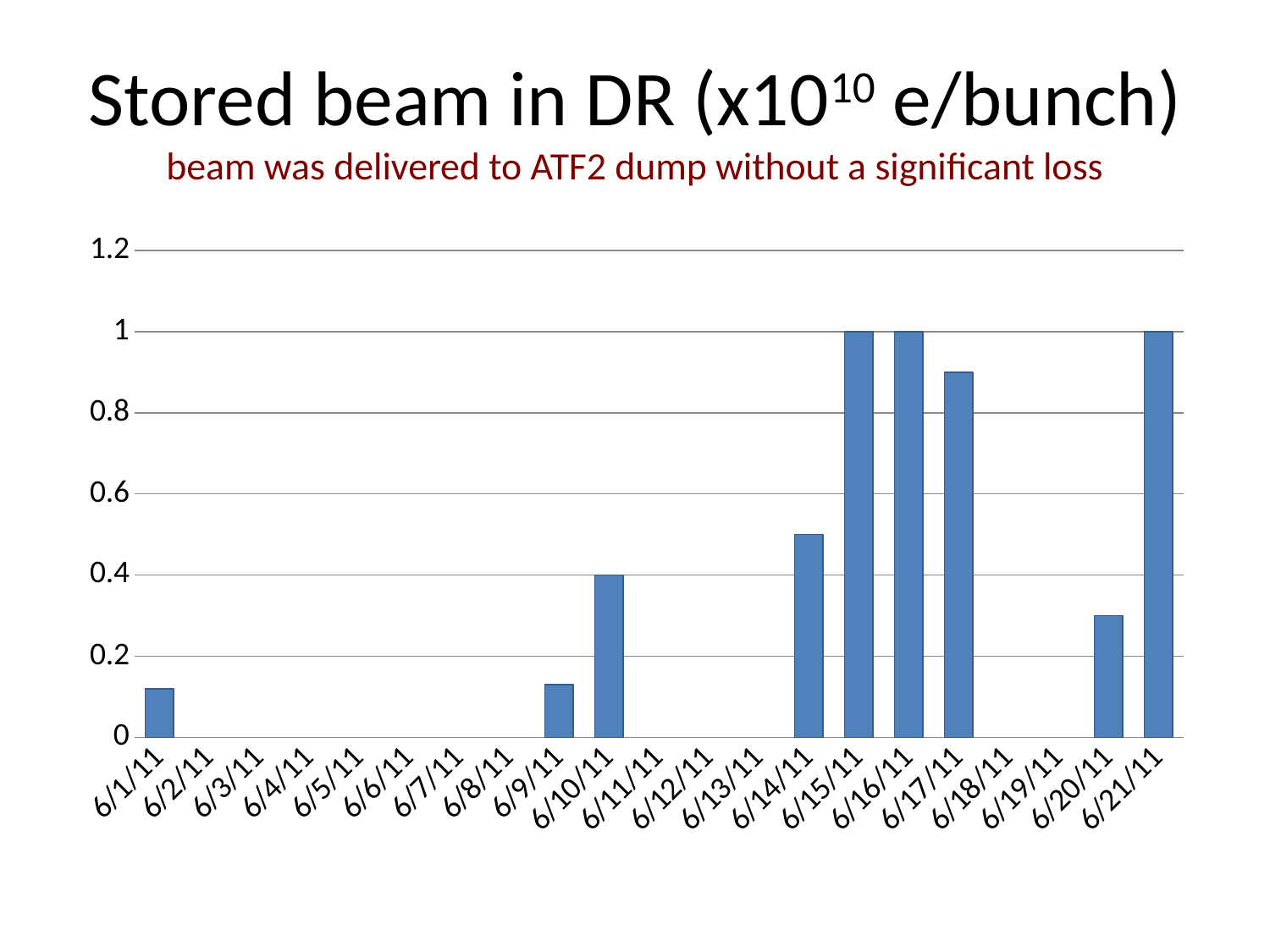
How many dates have a visible non-zero bar? 9 How many dates are shown on the x axis? 21 What type of chart is shown on the slide? bar chart What is the value for 6/21/11? 1 Is the value for 6/14/11 greater or less than 0.4? greater What is the value for 6/15/11? 1 Is the value for 6/1/11 greater or less than 0.2? less Is the value for 6/20/11 greater or less than 0.2? greater What is the title of the chart? Stored beam in DR (x10^10 e/bunch) Which is larger, the value for 6/14/11 or the value for 6/10/11? 6/14/11 What is the value for 6/10/11? 0.4